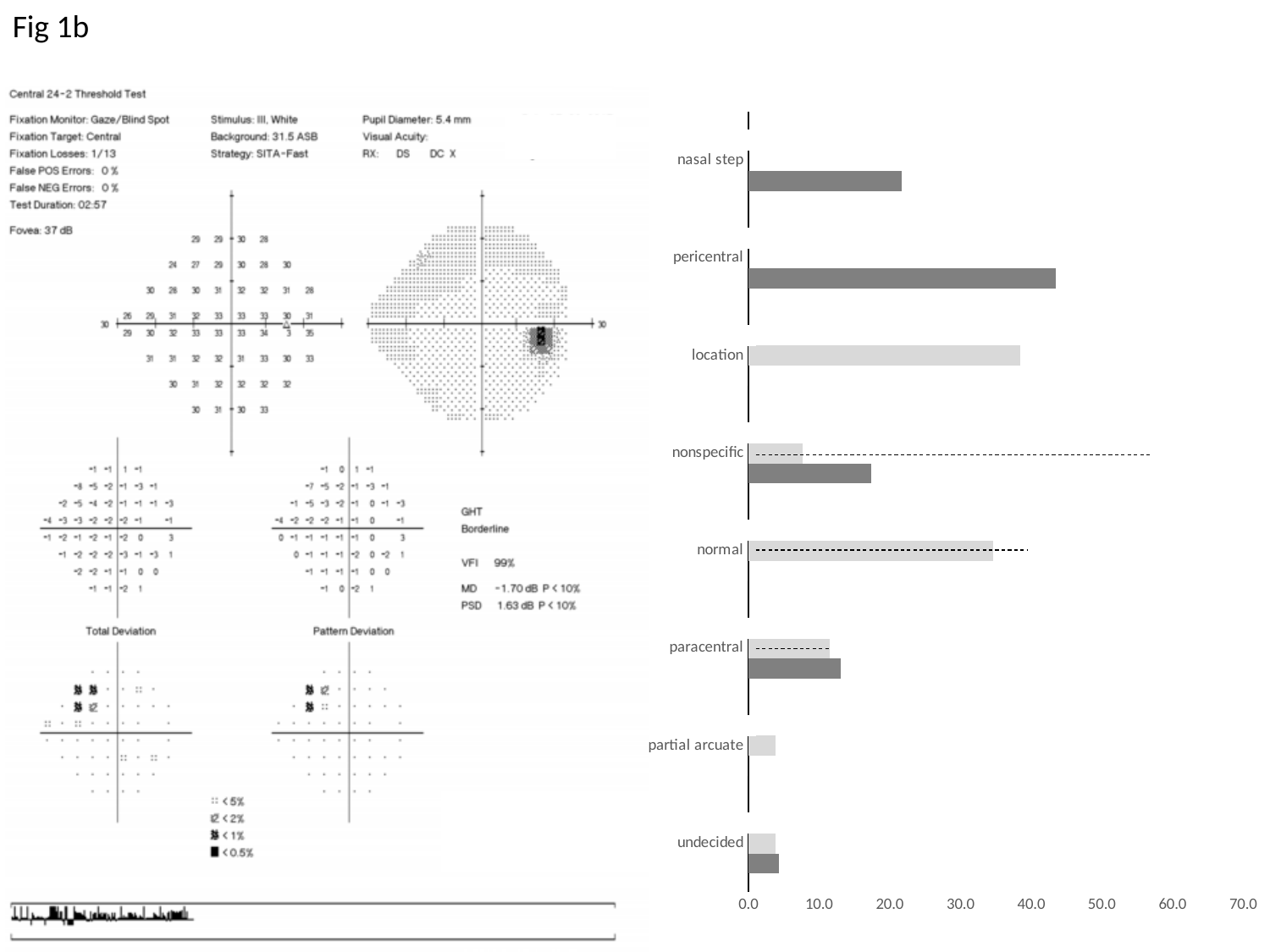
Is the light grey bar for normal greater or less than 30.0? greater What is the highest value shown on the horizontal axis of the bar chart? 70.0 Which bar is longer, location or normal? location For nonspecific, which bar is longer, the light grey bar or the dark grey bar? dark grey Is the bar for partial arcuate greater or less than 10.0? less Is the dark grey bar for pericentral greater or less than 40.0? greater Which category has the longest bar in the bar chart? pericentral How many categories are listed on the vertical axis of the bar chart? 8 Which bar is longer, nasal step or pericentral? pericentral What kind of chart is shown on the right side of the slide? bar chart